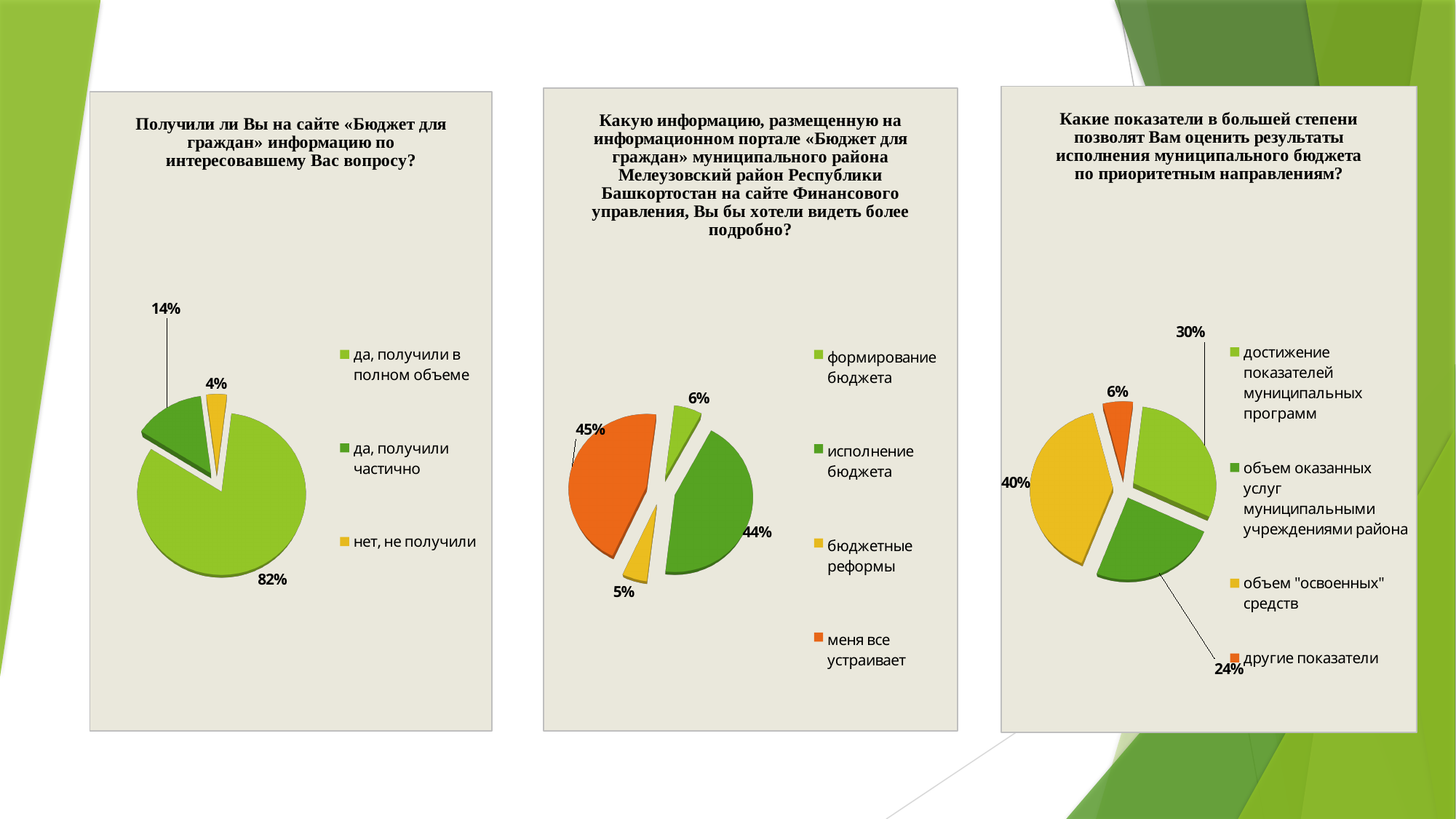
On the left pie chart, what share of respondents answered «да, получили в полном объеме»? 82% On the right pie chart, which category has the smallest share? другие показатели On the middle pie chart, which category has the largest share? меня все устраивает On the right pie chart, what is the value for «объем "освоенных" средств»? 40% On the left pie chart, what is the value for «нет, не получили»? 4% How many categories does the legend of the middle pie chart list? 4 On the left pie chart, which category has the smallest share? нет, не получили On the middle pie chart, which is larger: «формирование бюджета» or «бюджетные реформы»? формирование бюджета On the middle pie chart, what is the value for «исполнение бюджета»? 44% What type of chart is used on the right of the slide? pie chart On the left pie chart, what is the difference between «да, получили в полном объеме» and «да, получили частично»? 68% On the right pie chart, what is the value for «объем оказанных услуг муниципальными учреждениями района»? 24%